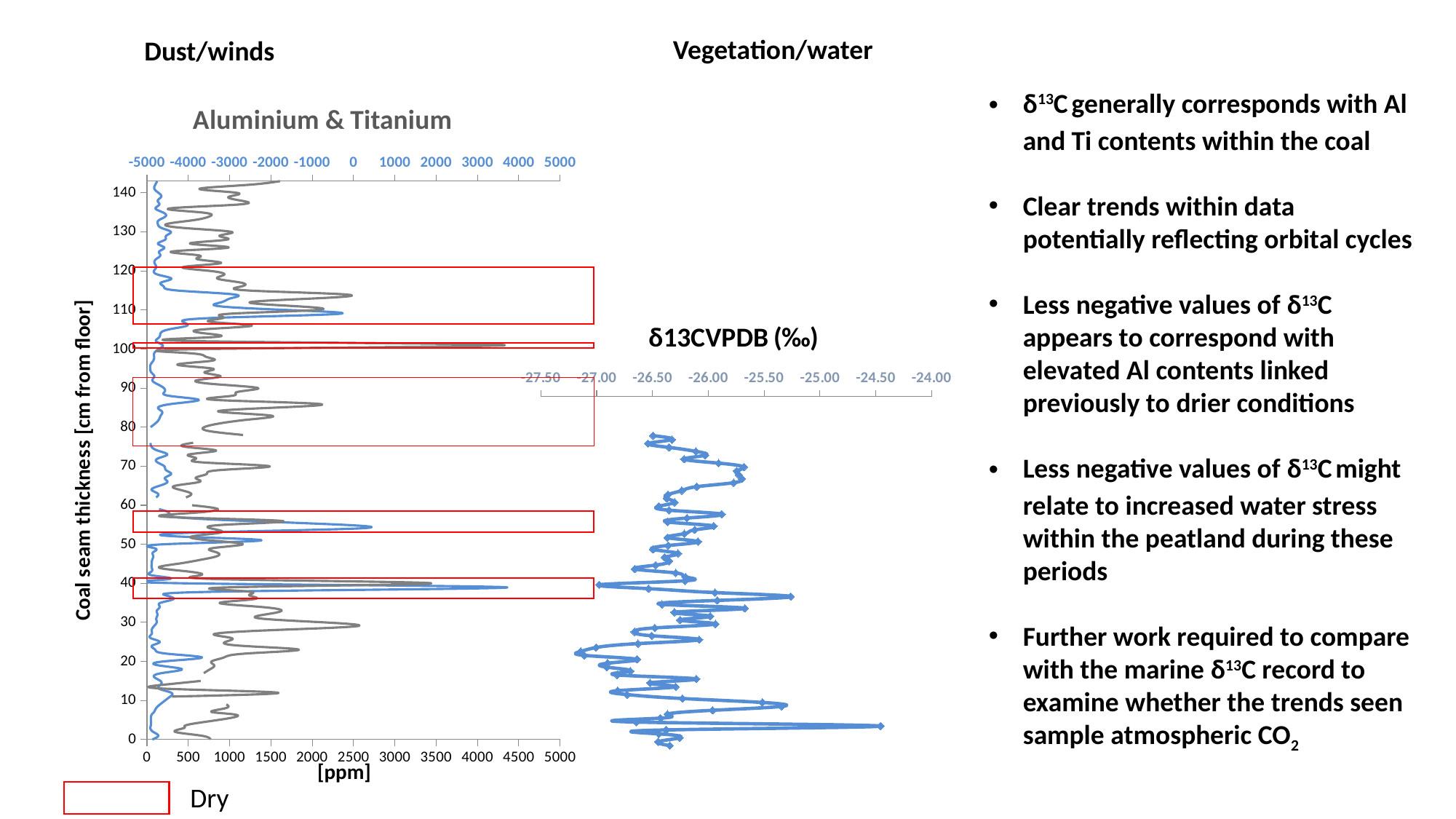
On the Aluminium & Titanium chart, is the peak value of the blue line at about 38 cm greater or less than 3500 ppm? greater How many red boxes marking 'Dry' periods are drawn over the Aluminium & Titanium chart? 5 What kind of chart is the Aluminium & Titanium chart? line chart How many data series are plotted on the Aluminium & Titanium chart? 2 What unit is shown on the bottom horizontal axis of the Aluminium & Titanium chart? [ppm] On the δ13CVPDB (‰) chart, is the value at about 3 cm (the rightmost point) greater or less than -25.00? greater What is the lowest tick value on the horizontal axis of the δ13CVPDB (‰) chart? -27.50 On the Aluminium & Titanium chart, is the peak value of the grey line at about 100 cm greater or less than 3000 ppm? greater What is the highest tick value on the vertical axis of the Aluminium & Titanium chart? 140 What is the title of the chart on the left of the slide? Aluminium & Titanium What is the title of the chart on the right of the slide? δ13CVPDB (‰) What is the label of the vertical axis on the Aluminium & Titanium chart? Coal seam thickness [cm from floor]